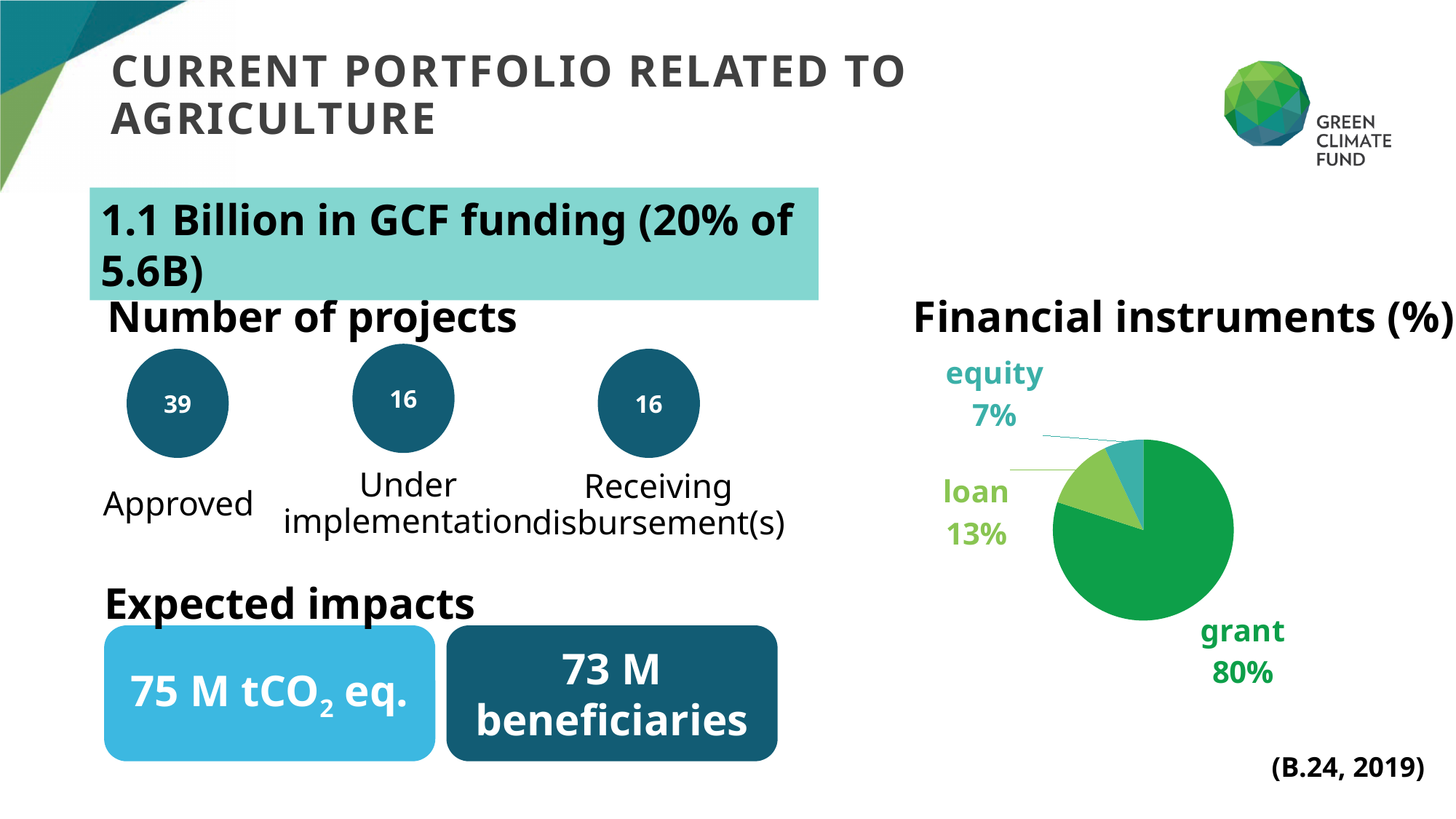
Which financial instrument has the largest share in the pie chart? grant What percentage does equity account for in the Financial instruments pie chart? 7% In the Financial instruments pie chart, how many percentage points larger is grant than loan? 67% What colour is the grant slice in the Financial instruments pie chart? green What kind of chart is used to show the financial instruments? pie chart In the Financial instruments pie chart, what is the difference between the loan and equity shares? 6% How many slices does the Financial instruments pie chart have? 3 What share of the Financial instruments pie chart is grant? 80% Which financial instrument has the smallest share in the pie chart? equity What percentage does loan account for in the Financial instruments pie chart? 13% In the Financial instruments pie chart, which is larger: loan or equity? loan What is the title of the pie chart on the slide? Financial instruments (%)